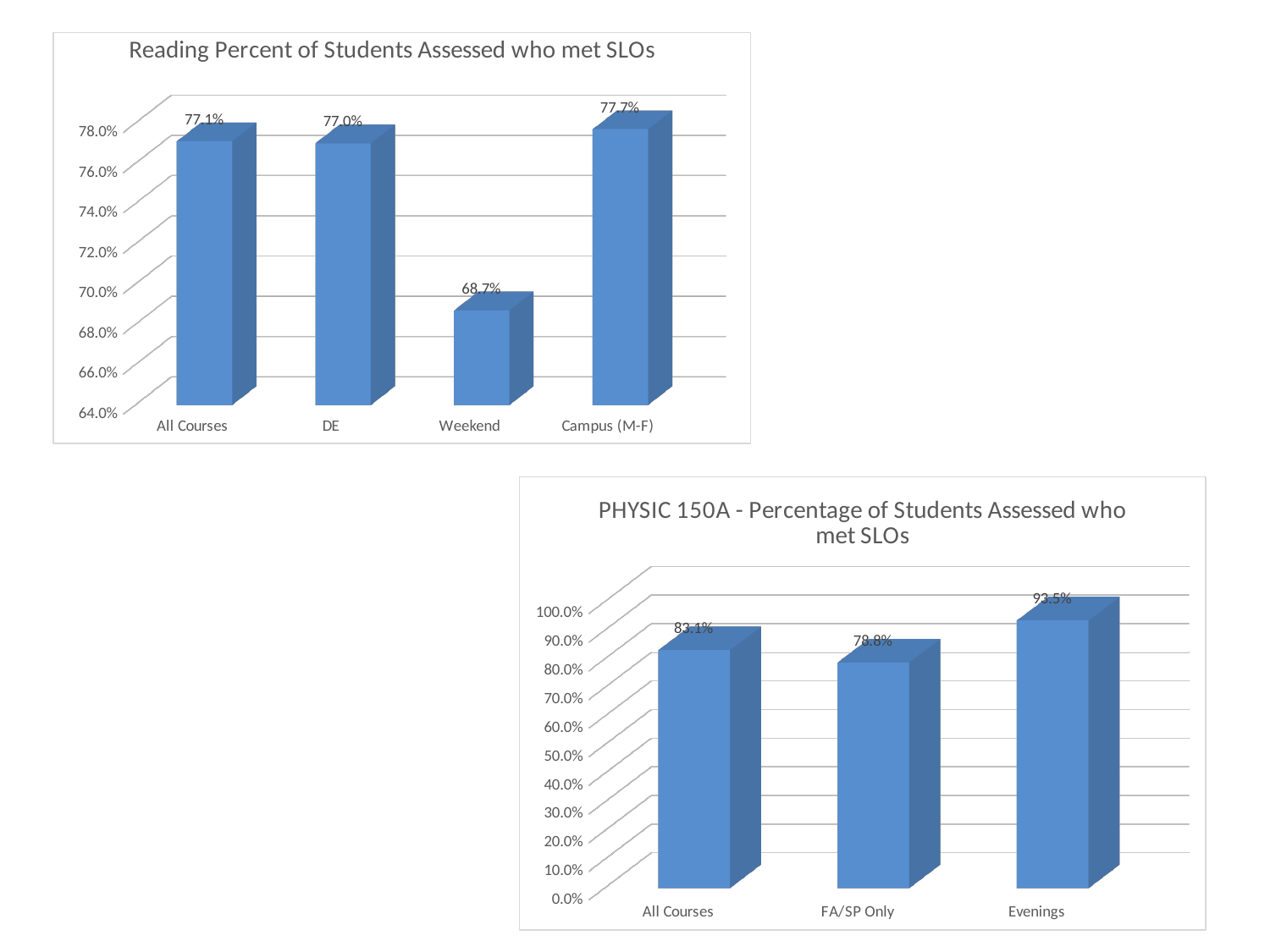
In the 'PHYSIC 150A - Percentage of Students Assessed who met SLOs' chart, which category has the highest value? Evenings In the 'Reading Percent of Students Assessed who met SLOs' chart, what is the value for Campus (M-F)? 77.7% In the 'PHYSIC 150A - Percentage of Students Assessed who met SLOs' chart, what is the difference between Evenings and All Courses? 10.4% What kind of chart is the 'PHYSIC 150A - Percentage of Students Assessed who met SLOs' chart? Bar chart In the 'PHYSIC 150A - Percentage of Students Assessed who met SLOs' chart, what is the value for FA/SP Only? 78.8% In the 'PHYSIC 150A - Percentage of Students Assessed who met SLOs' chart, which is larger, All Courses or FA/SP Only? All Courses In the 'Reading Percent of Students Assessed who met SLOs' chart, what is the value for Weekend? 68.7% In the 'Reading Percent of Students Assessed who met SLOs' chart, is the value for Weekend greater or less than 70.0%? less In the 'Reading Percent of Students Assessed who met SLOs' chart, what is the difference between Campus (M-F) and Weekend? 9.0% In the 'Reading Percent of Students Assessed who met SLOs' chart, how many categories are shown? 4 In the 'Reading Percent of Students Assessed who met SLOs' chart, which category has the lowest value? Weekend In the 'PHYSIC 150A - Percentage of Students Assessed who met SLOs' chart, how many categories are shown? 3